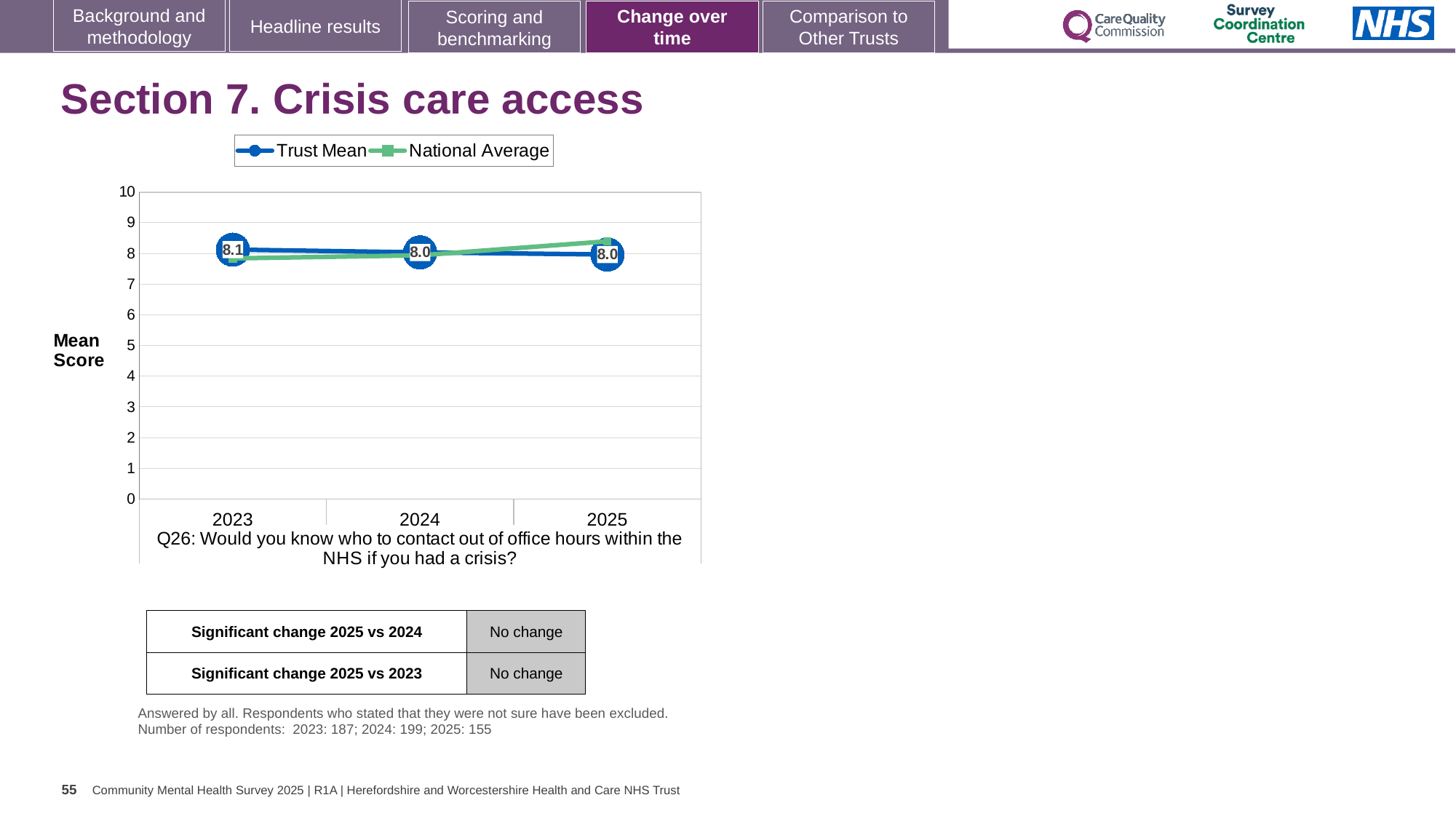
What is the label of the y axis? Mean Score How many series does the legend list? 2 How many years are plotted on the x axis? 3 What is the Trust Mean value for 2023? 8.1 What is the Trust Mean value for 2024? 8.0 What kind of chart is shown on the slide? line chart Is the National Average value for 2025 greater or less than 8? greater What is the Trust Mean value for 2025? 8.0 Does the National Average rise or fall from 2023 to 2025? rise What is the difference between the Trust Mean in 2023 and in 2025? 0.1 In which year is the Trust Mean highest? 2023 Which is larger, the Trust Mean in 2023 or the Trust Mean in 2025? 2023